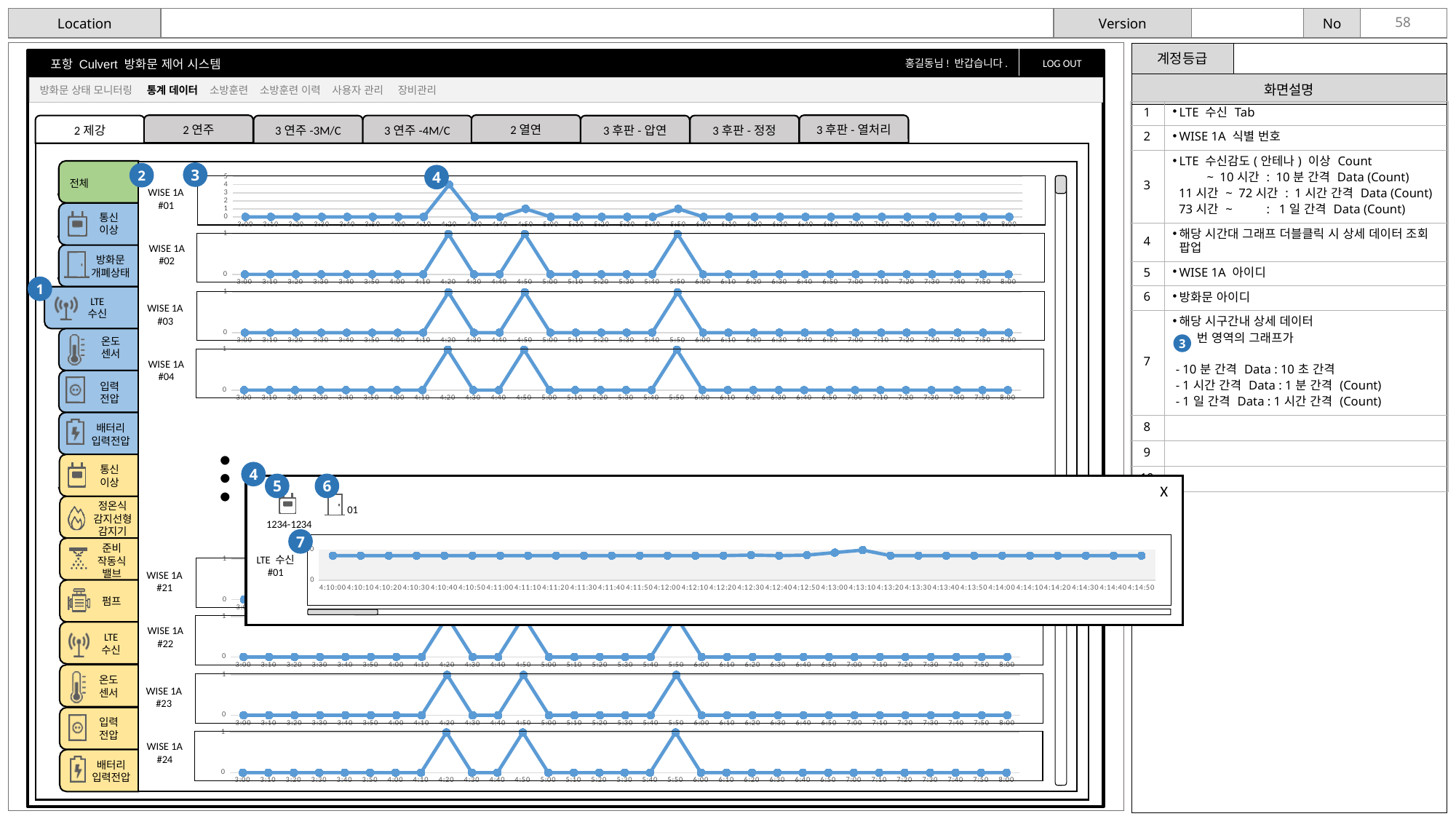
On the WISE 1A #04 chart, at which three time labels does the line peak? 4:20, 4:50, 5:50 What is the last time label on the x axis of the WISE 1A #03 chart? 8:00 On the WISE 1A #01 chart, is the value at 4:50 greater or less than 3? less What kind of chart is the WISE 1A #02 chart? line chart How many WISE 1A charts are shown on the main screen? 8 What is the last time label on the x axis of the popup chart labelled LTE 수신 #01? 4:14:50 On the WISE 1A #02 chart, at how many time points does the line rise to a peak? 3 What is the first time label on the x axis of the popup chart labelled LTE 수신 #01? 4:10:00 What is the first time label on the x axis of the WISE 1A #02 chart? 3:00 On the WISE 1A #01 chart, at which time label does the line reach its highest point? 4:20 On the WISE 1A #01 chart, is the value at 4:20 greater or less than 3? greater On the WISE 1A #01 chart, which is larger, the value at 4:20 or the value at 4:50? 4:20